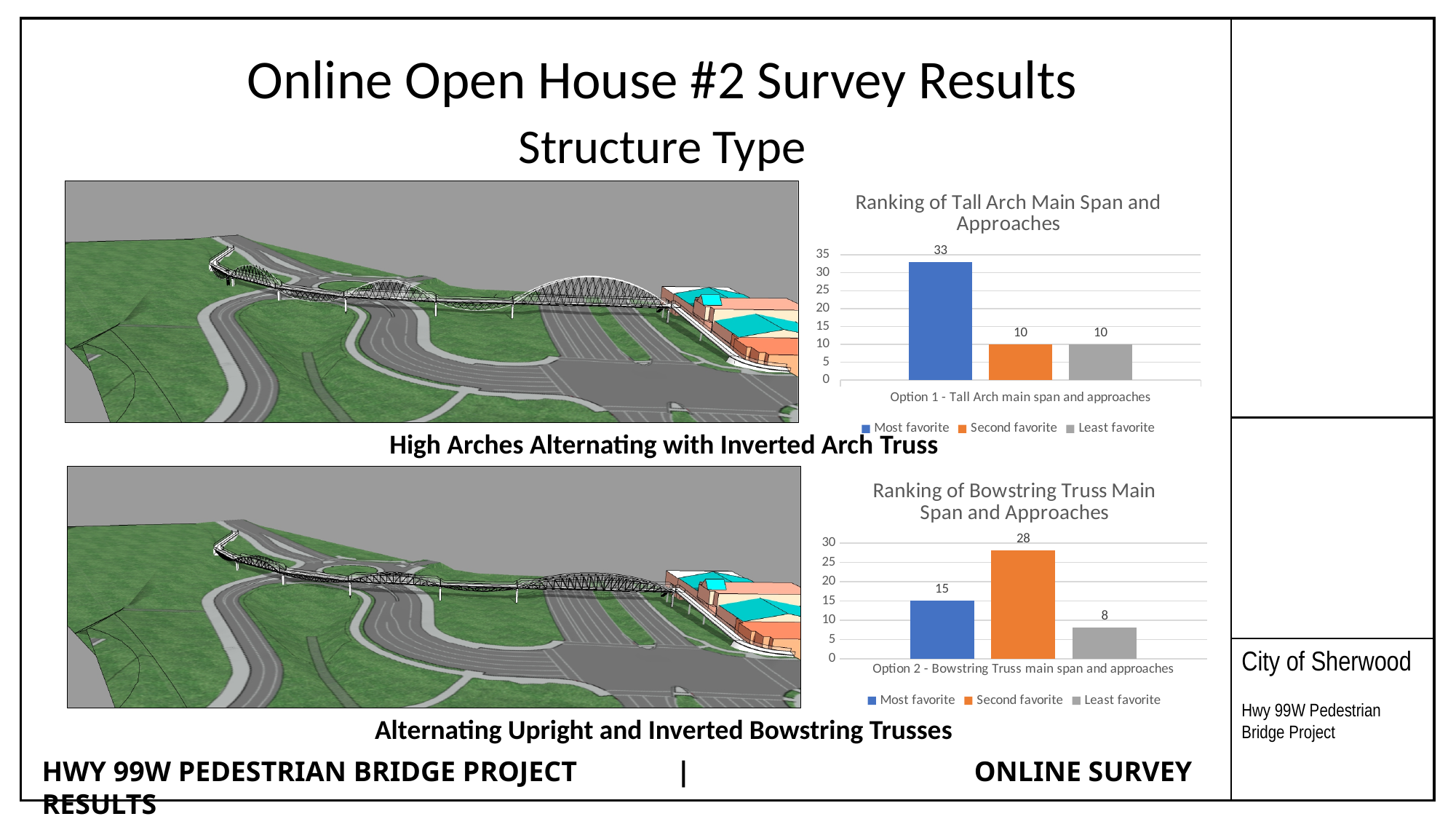
In the 'Ranking of Tall Arch Main Span and Approaches' chart, which series has the highest value? Most favorite In the 'Ranking of Bowstring Truss Main Span and Approaches' chart, what is the value for Least favorite? 8 In the 'Ranking of Bowstring Truss Main Span and Approaches' chart, what colour is the Second favorite bar? Orange In the 'Ranking of Bowstring Truss Main Span and Approaches' chart, which is larger, Most favorite or Least favorite? Most favorite In the 'Ranking of Tall Arch Main Span and Approaches' chart, what is the value for Least favorite? 10 In the 'Ranking of Tall Arch Main Span and Approaches' chart, what is the difference between Most favorite and Second favorite? 23 What kind of chart is the 'Ranking of Bowstring Truss Main Span and Approaches' chart? Bar chart In the 'Ranking of Bowstring Truss Main Span and Approaches' chart, which series has the lowest value? Least favorite In the 'Ranking of Bowstring Truss Main Span and Approaches' chart, what is the difference between Second favorite and Most favorite? 13 How many series does the legend of the 'Ranking of Tall Arch Main Span and Approaches' chart list? 3 In the 'Ranking of Tall Arch Main Span and Approaches' chart, what is the value for Most favorite? 33 In the 'Ranking of Bowstring Truss Main Span and Approaches' chart, what is the value for Second favorite? 28